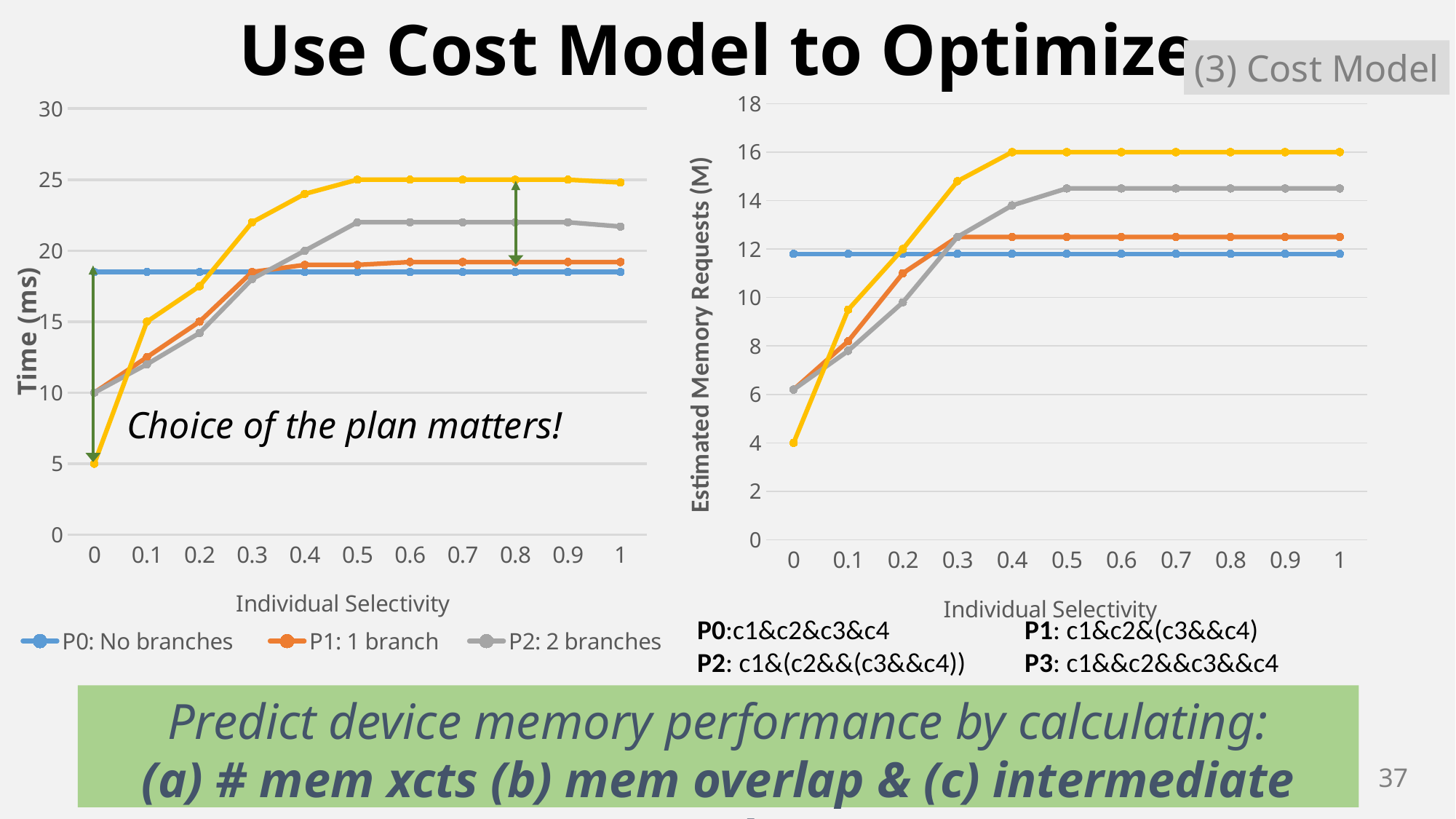
On the left chart, how many series does the legend list? 3 What kind of chart is the left chart showing Time (ms)? line chart On the left chart, is the value for P2: 2 branches at selectivity 0.5 greater or less than 20? greater What is the x-axis title of the left chart? Individual Selectivity On the left chart, is the value for P0: No branches at selectivity 0.5 greater or less than 20? less On the right chart, is the value of the gray line at selectivity 0.6 greater or less than 14? greater On the left chart, does the P2: 2 branches line rise or fall between selectivity 0 and 0.5? rise On the right chart, what is the y-axis title? Estimated Memory Requests (M) On the left chart, how many x-axis points (selectivity values) are plotted? 11